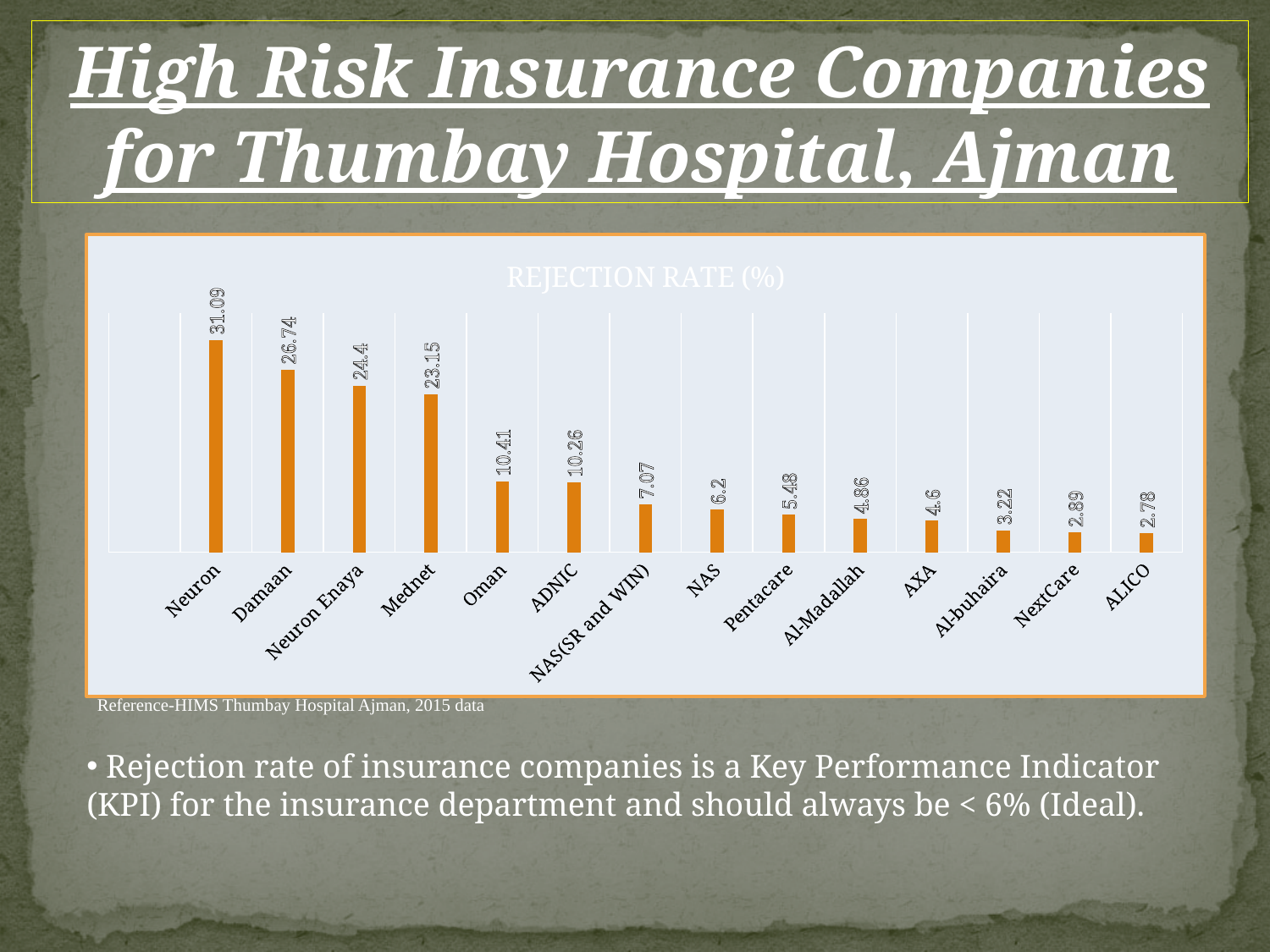
What is the rejection rate for Neuron? 31.09 Which insurance company has the lowest rejection rate? ALICO What is the title of the chart? REJECTION RATE (%) What is the difference between the rejection rates of Neuron and Damaan? 4.35 Which insurance company has the highest rejection rate? Neuron What is the rejection rate for NAS(SR and WIN)? 7.07 Do the rejection rates rise or fall from left to right across the chart? Fall How many insurance companies are shown in the chart? 14 Which has a higher rejection rate, Oman or NAS? Oman What is the rejection rate for Pentacare? 5.48 What is the rejection rate for Mednet? 23.15 What kind of chart is shown on the slide? Bar chart